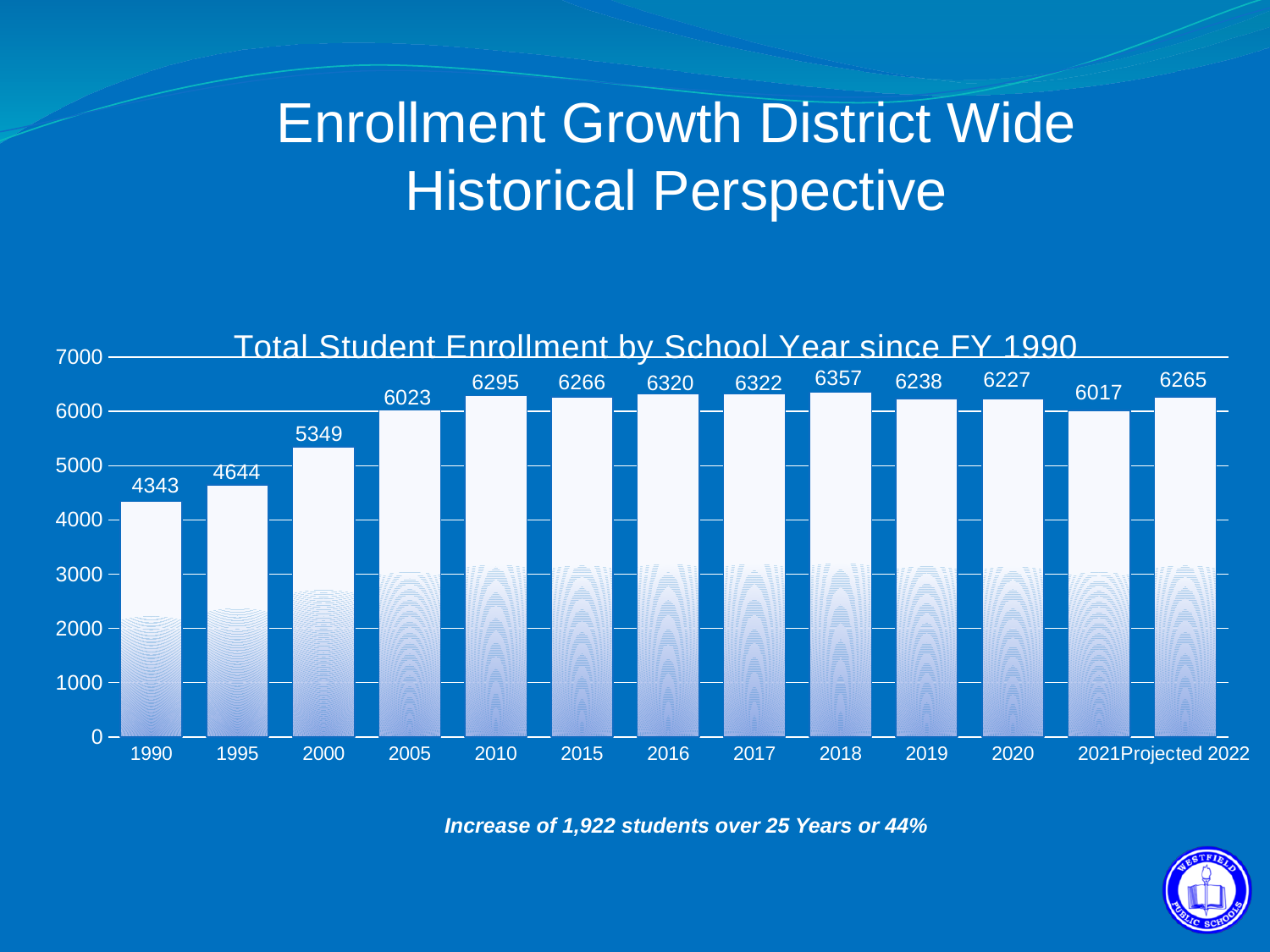
Which year has higher enrollment, 2005 or 2010? 2010 Which school year has the highest total student enrollment? 2018 What kind of chart is shown on the slide? Bar chart What is the difference in enrollment between 2018 and 2021? 340 Which school year has the lowest total student enrollment? 1990 What is the projected total student enrollment for 2022? 6265 What is the title of the chart? Total Student Enrollment by School Year since FY 1990 What is the total student enrollment for 1990? 4343 What is the total student enrollment for 2018? 6357 Is the enrollment for 2000 greater or less than 5000? greater What is the difference in enrollment between 2000 and 1995? 705 How many school years are shown on the chart? 13